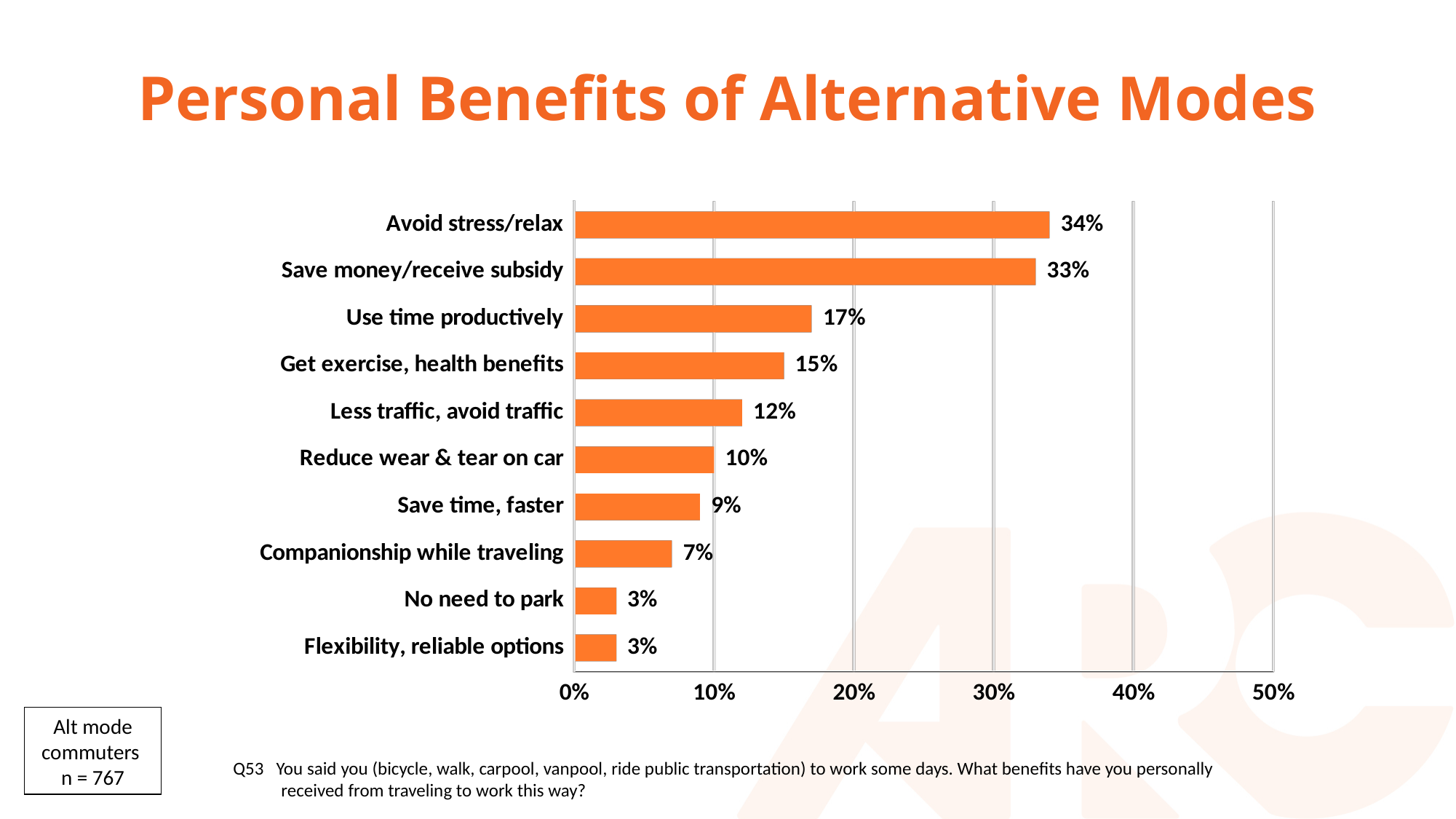
What is the title of the slide? Personal Benefits of Alternative Modes How many benefit categories are shown in the chart? 10 What is the difference between 'Use time productively' and 'Get exercise, health benefits'? 2% What is the sample size (n) of alt mode commuters noted on the slide? 767 What is the difference between 'Avoid stress/relax' and 'Save money/receive subsidy'? 1% Is the value for 'Save money/receive subsidy' greater or less than 30%? greater Which benefit has the highest percentage in the chart? Avoid stress/relax What is the value shown for 'Use time productively'? 17% What type of chart is shown on the slide? Bar chart What percentage of alt mode commuters cited 'Avoid stress/relax' as a personal benefit? 34% What percentage is shown for 'Companionship while traveling'? 7% Which is larger: 'Less traffic, avoid traffic' or 'Reduce wear & tear on car'? Less traffic, avoid traffic